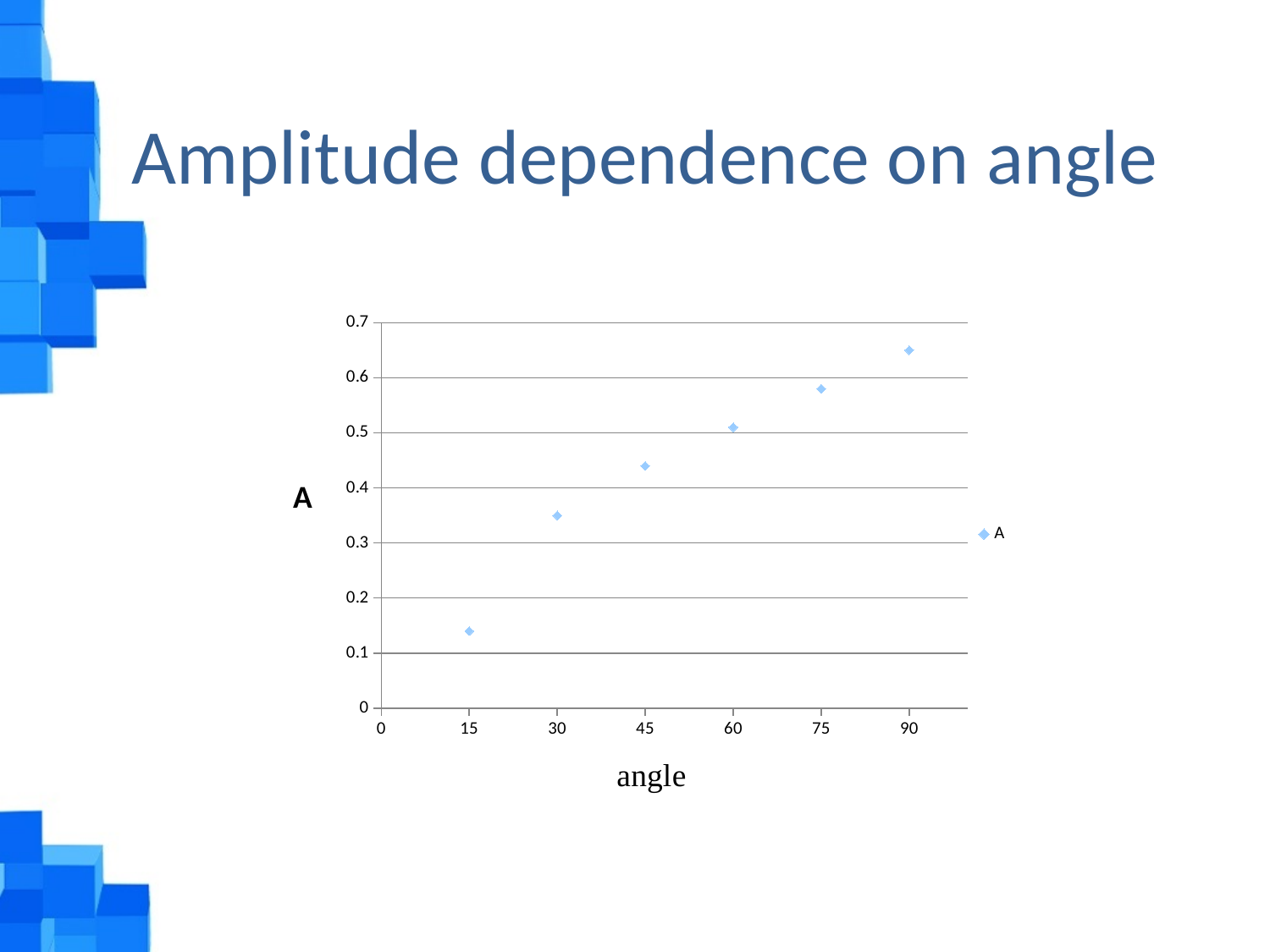
What kind of chart is shown on the slide? scatter chart What is the name of the series shown in the legend? A Is the value of A at angle 30 greater or less than 0.4? less Is the value of A at angle 90 greater or less than 0.6? greater What is the label of the x axis? angle At which angle is the value of A highest? 90 How many data points are plotted in the chart? 6 Do the values of A rise or fall as the angle increases? rise Which has the larger value of A: angle 45 or angle 75? 75 At which angle is the value of A lowest? 15 Is the value of A at angle 15 greater or less than 0.2? less How many series does the legend list? 1